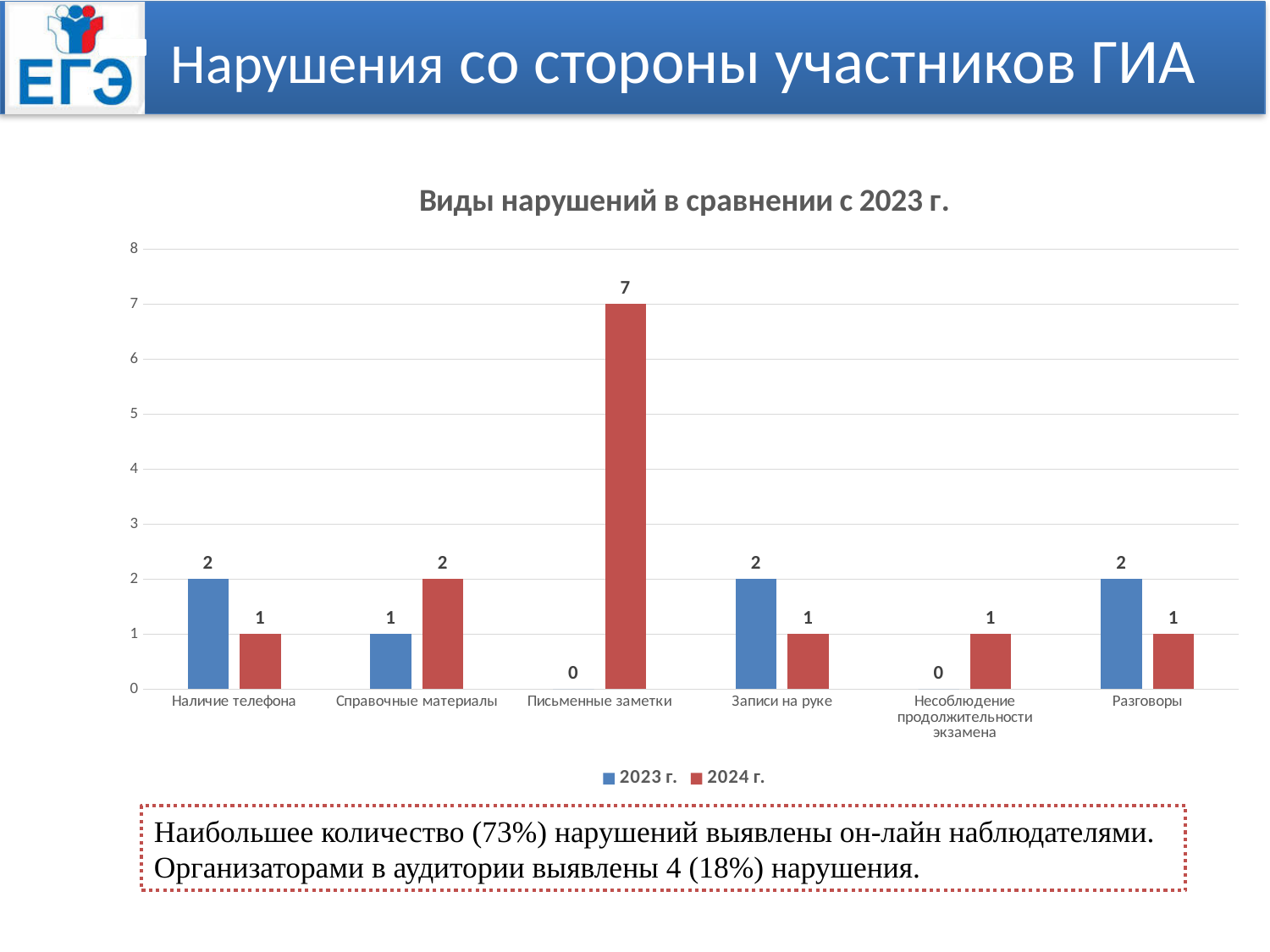
Which is larger for Записи на руке: the 2023 г. value or the 2024 г. value? 2023 г. What kind of chart is shown on the slide? Bar chart How many categories are shown on the x axis? 6 What is the value for 2024 г. for Справочные материалы? 2 What is the value for 2024 г. for Письменные заметки? 7 What is the value for 2023 г. for Наличие телефона? 2 How many series does the legend list? 2 Which category has the highest value for 2024 г.? Письменные заметки Which colour represents the 2024 г. series? Red What is the difference between the 2024 г. and 2023 г. values for Письменные заметки? 7 What is the value for 2023 г. for Несоблюдение продолжительности экзамена? 0 What is the title of the chart? Виды нарушений в сравнении с 2023 г.